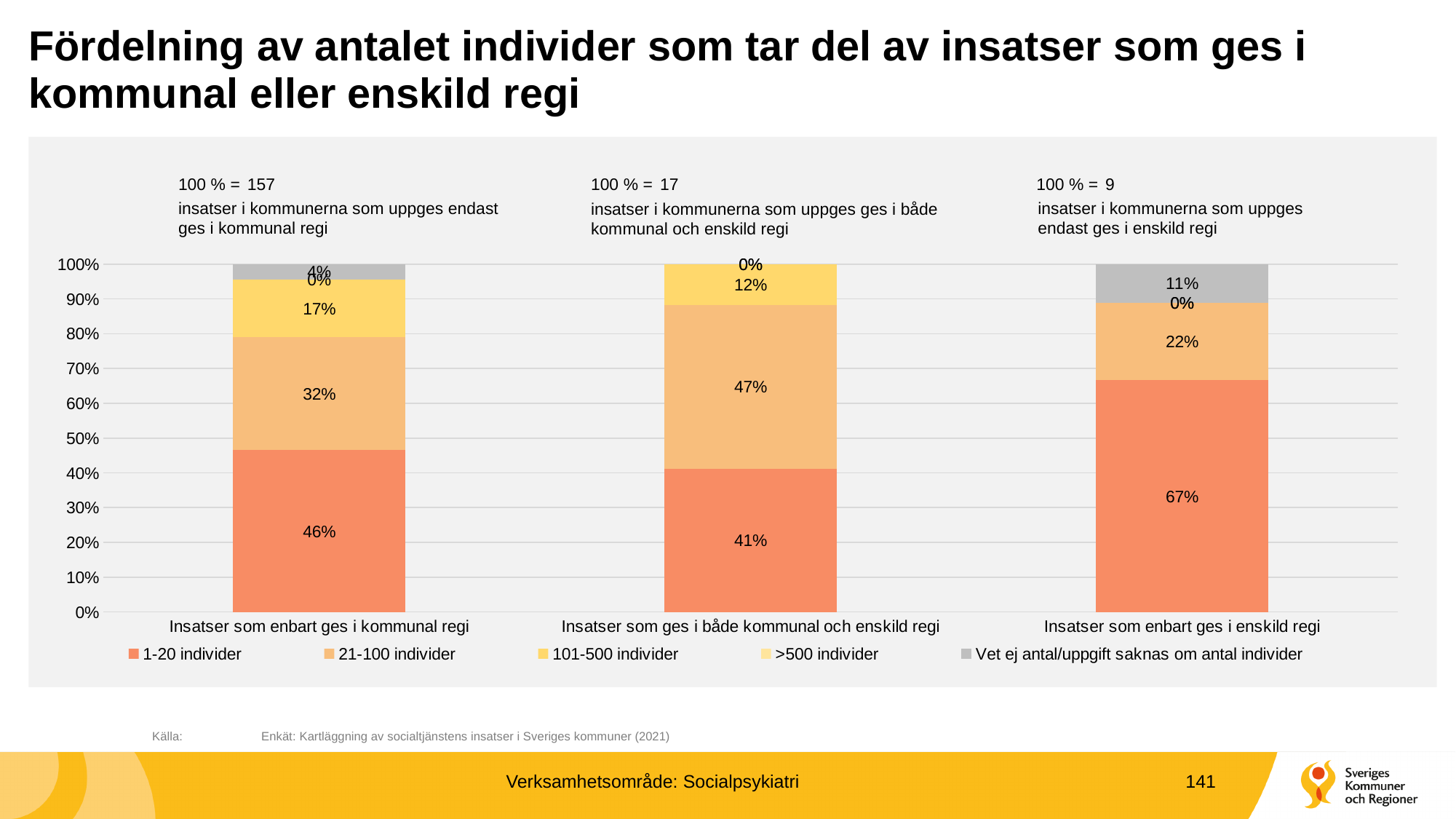
What is the value for '21-100 individer' in the 'Insatser som enbart ges i enskild regi' bar? 22% What is the value for '21-100 individer' in the 'Insatser som ges i både kommunal och enskild regi' bar? 47% Which has a larger '21-100 individer' share: 'Insatser som enbart ges i kommunal regi' or 'Insatser som ges i både kommunal och enskild regi'? Insatser som ges i både kommunal och enskild regi What is the value for '101-500 individer' in the 'Insatser som enbart ges i kommunal regi' bar? 17% What is the value for 'Vet ej antal/uppgift saknas om antal individer' in the 'Insatser som enbart ges i enskild regi' bar? 11% What share of 'Insatser som enbart ges i enskild regi' is '1-20 individer'? 67% How many percentage points higher is the '1-20 individer' share for 'Insatser som enbart ges i enskild regi' than for 'Insatser som enbart ges i kommunal regi'? 21 percentage points What kind of chart is shown on the slide? Stacked bar chart What percentage of the 'Insatser som enbart ges i kommunal regi' bar is '1-20 individer'? 46% How many series does the legend list? 5 Which category has the largest share of '1-20 individer'? Insatser som enbart ges i enskild regi How many categories (bars) are shown on the x axis? 3